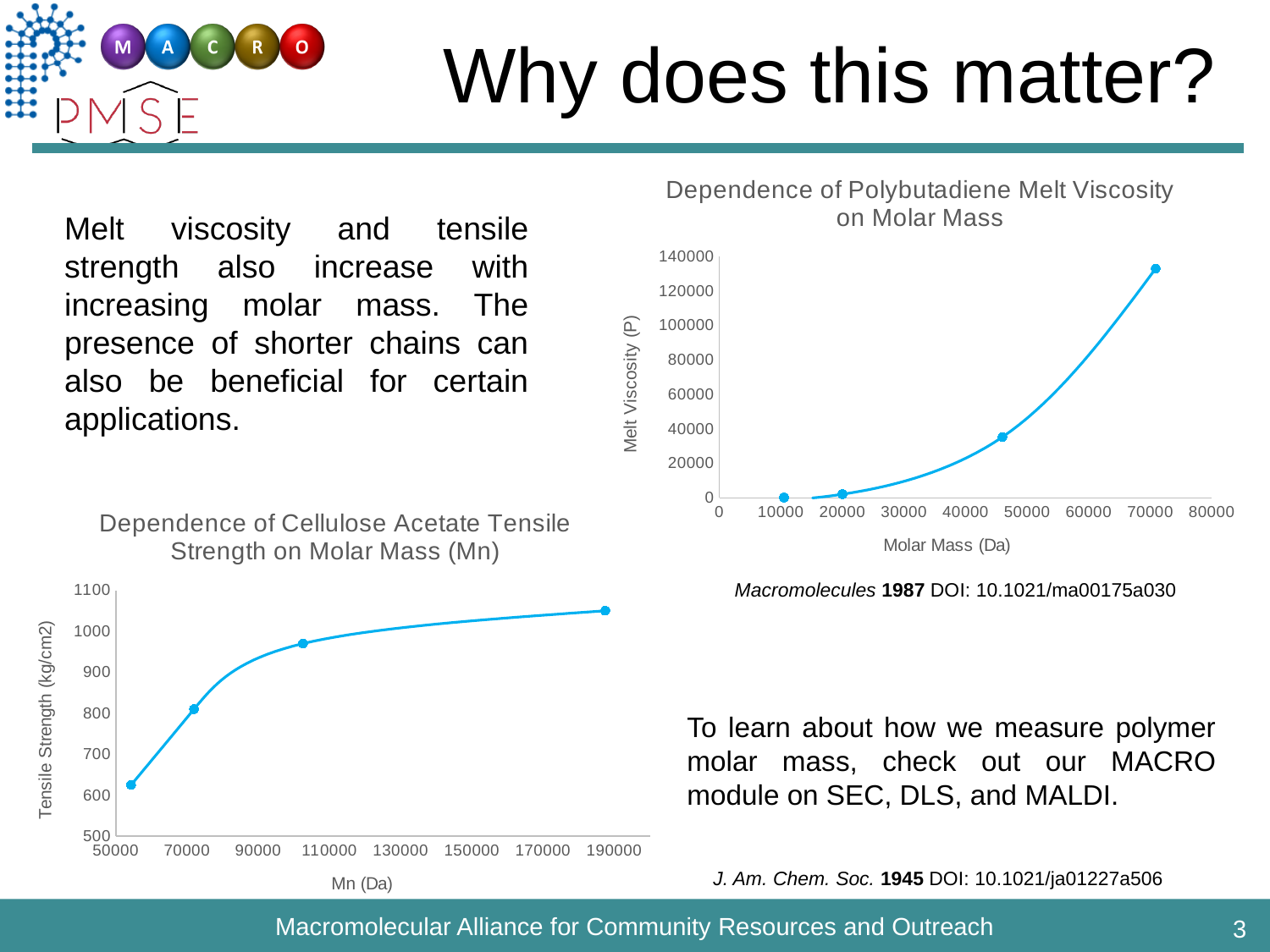
What is the x-axis label of the 'Dependence of Cellulose Acetate Tensile Strength on Molar Mass (Mn)' chart? Mn (Da) In the 'Dependence of Polybutadiene Melt Viscosity on Molar Mass' chart, does melt viscosity rise or fall as molar mass increases? Rise In the 'Dependence of Cellulose Acetate Tensile Strength on Molar Mass (Mn)' chart, how many data points are plotted? 4 In the 'Dependence of Cellulose Acetate Tensile Strength on Molar Mass (Mn)' chart, does tensile strength rise or fall as Mn increases? Rise In the 'Dependence of Cellulose Acetate Tensile Strength on Molar Mass (Mn)' chart, is the tensile strength of the highest-Mn data point greater or less than 1000? greater What kind of chart is the 'Dependence of Polybutadiene Melt Viscosity on Molar Mass' chart? Line chart In the 'Dependence of Cellulose Acetate Tensile Strength on Molar Mass (Mn)' chart, is the tensile strength of the lowest-Mn data point greater or less than 700? less In the 'Dependence of Polybutadiene Melt Viscosity on Molar Mass' chart, is the melt viscosity of the highest data point greater or less than 120000? greater What is the y-axis label of the 'Dependence of Polybutadiene Melt Viscosity on Molar Mass' chart? Melt Viscosity (P) In the 'Dependence of Polybutadiene Melt Viscosity on Molar Mass' chart, how many data points are plotted? 4 What kind of chart is the 'Dependence of Cellulose Acetate Tensile Strength on Molar Mass (Mn)' chart? Line chart